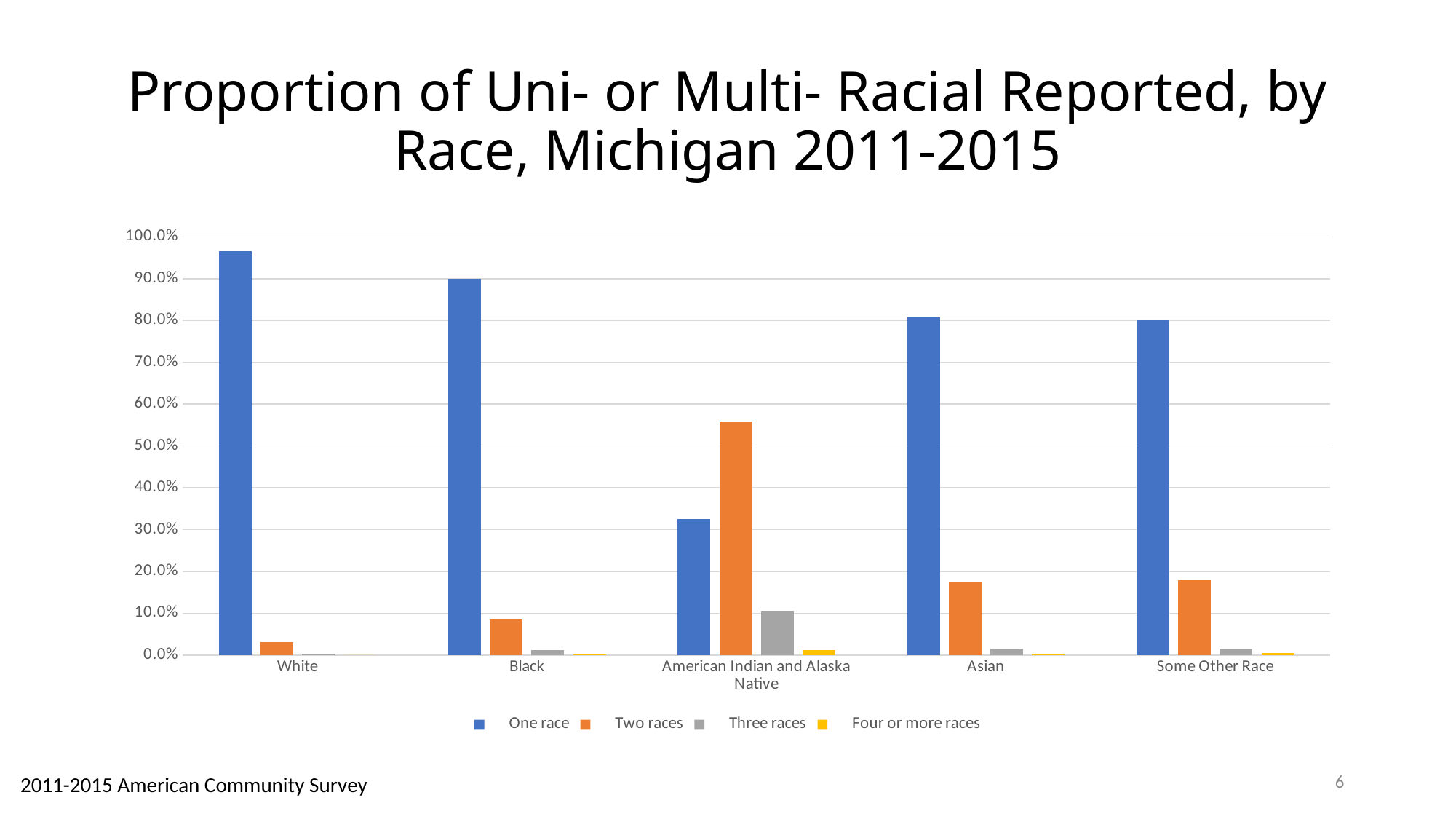
For American Indian and Alaska Native, which is larger: One race or Two races? Two races How many series does the legend list? 4 What colour are the bars for the Two races series? orange How many race categories are shown on the x axis? 5 Is the value for Two races for American Indian and Alaska Native greater or less than 50.0%? greater Is the value for One race for American Indian and Alaska Native greater or less than 40.0%? less What kind of chart is shown on the slide? bar chart Which is larger: the Two races value for Black or the Two races value for Asian? Asian Is the value for One race for White greater or less than 90.0%? greater Which race category has the lowest value for One race? American Indian and Alaska Native Which race category has the highest value for One race? White Which race category has the highest value for Two races? American Indian and Alaska Native